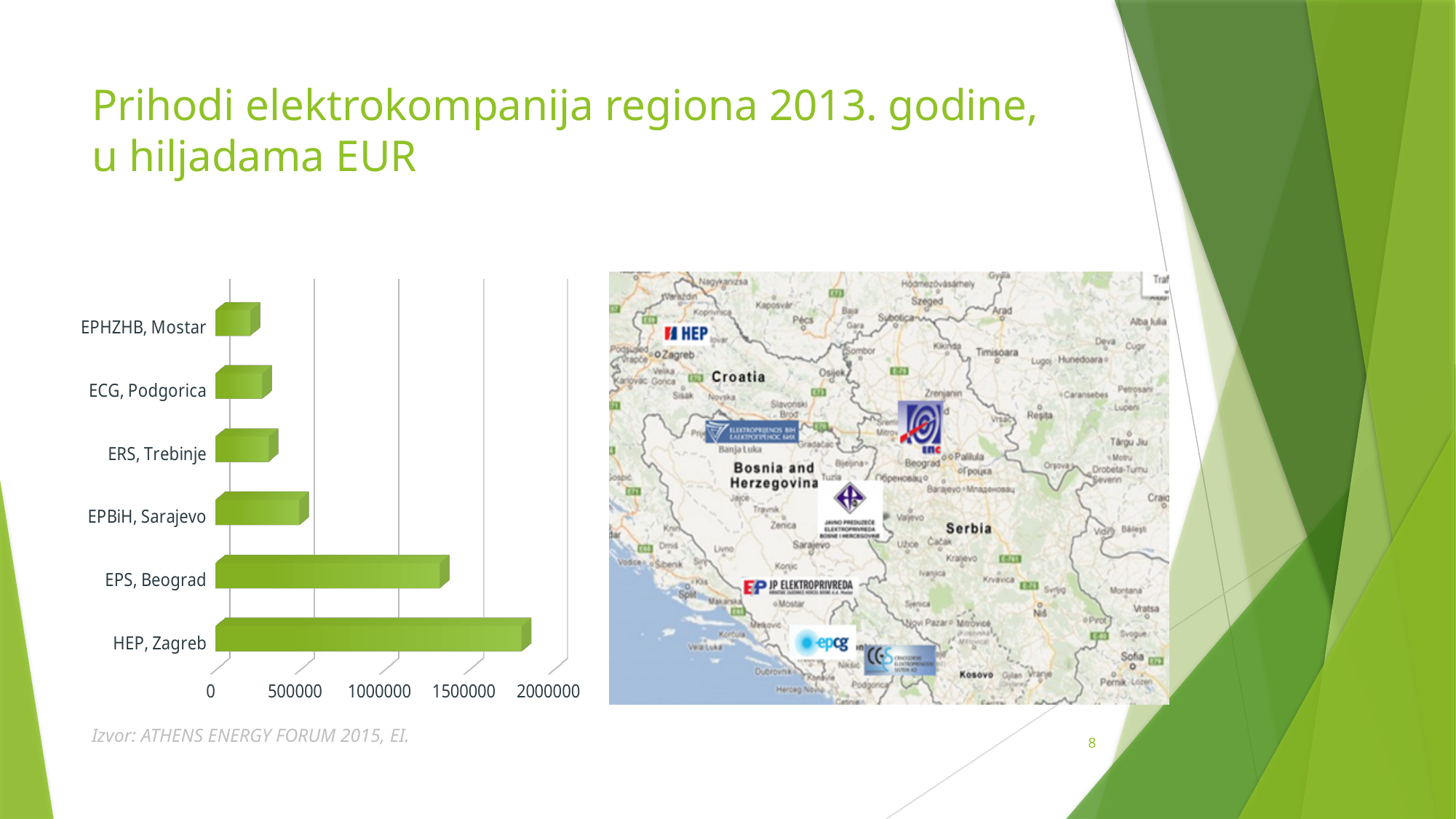
Which company has the highest revenue in the bar chart? HEP, Zagreb Is the value for ERS, Trebinje greater or less than 500000? less Which is larger, the value for EPBiH, Sarajevo or ERS, Trebinje? EPBiH, Sarajevo Is the value for EPS, Beograd greater or less than 1000000? greater Is the value for EPS, Beograd greater or less than 1500000? less How many companies are shown in the bar chart? 6 What kind of chart is shown on the slide? bar chart Which is larger, the value for HEP, Zagreb or EPS, Beograd? HEP, Zagreb What is the title of the slide containing the chart? Prihodi elektrokompanija regiona 2013. godine, u hiljadama EUR